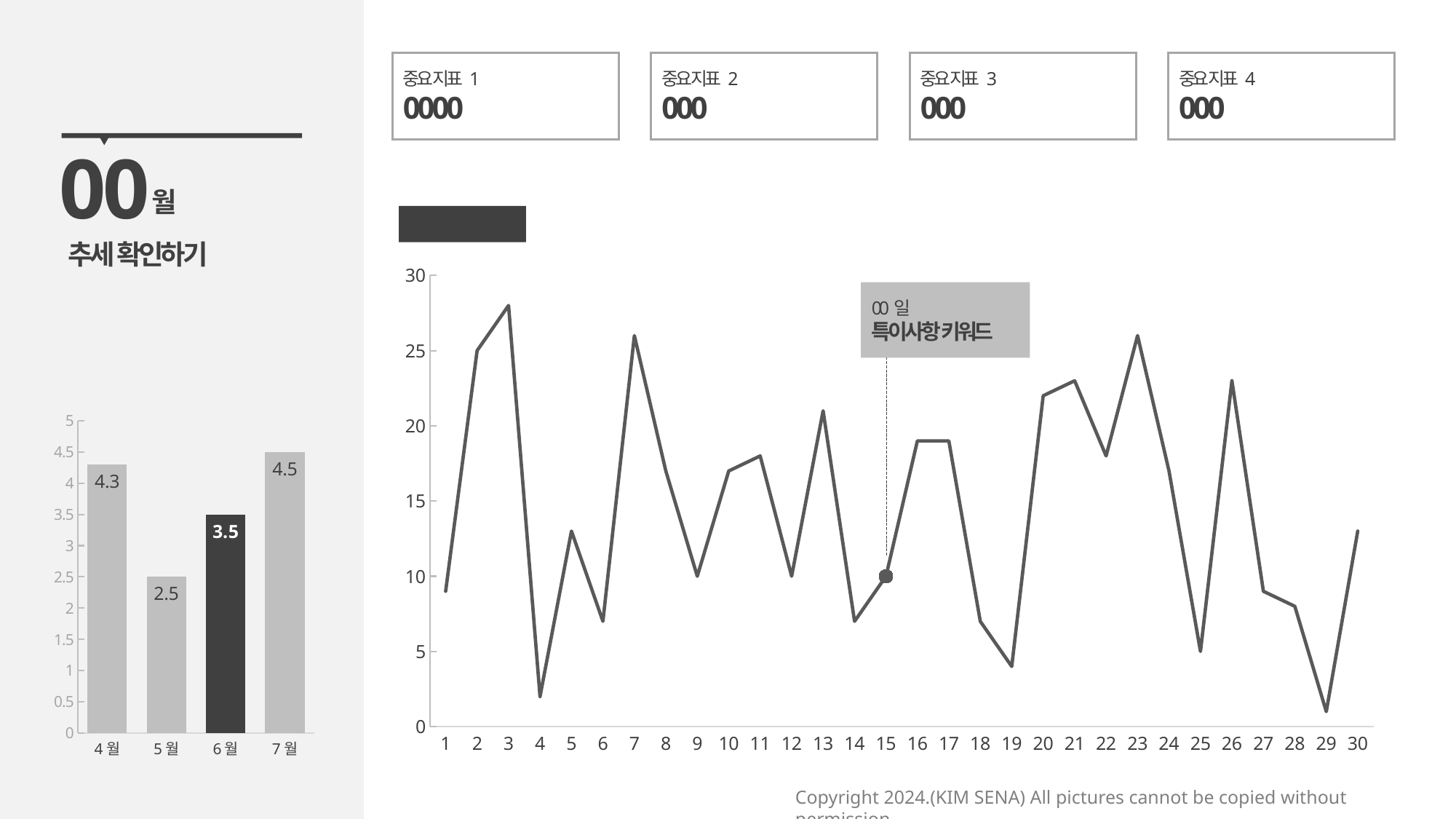
On the bar chart on the left, which month has the highest value? 7월 On the bar chart on the left, which month has the lowest value? 5월 On the bar chart on the left, how many months are shown? 4 On the bar chart on the left, what is the value for 4월? 4.3 On the bar chart on the left, what is the value for 6월? 3.5 On the line chart on the right, how many days are shown on the x axis? 30 On the line chart on the right, is the value for day 29 greater or less than 5? less On the bar chart on the left, what is the difference between the values for 7월 and 5월? 2 On the line chart on the right, which day is marked with a callout labelled '00 일 특이사항 키워드'? 15 What kind of chart is the chart on the right side of the slide? line chart On the line chart on the right, is the value for day 3 greater or less than 25? greater On the bar chart on the left, which is larger, the value for 4월 or the value for 6월? 4월